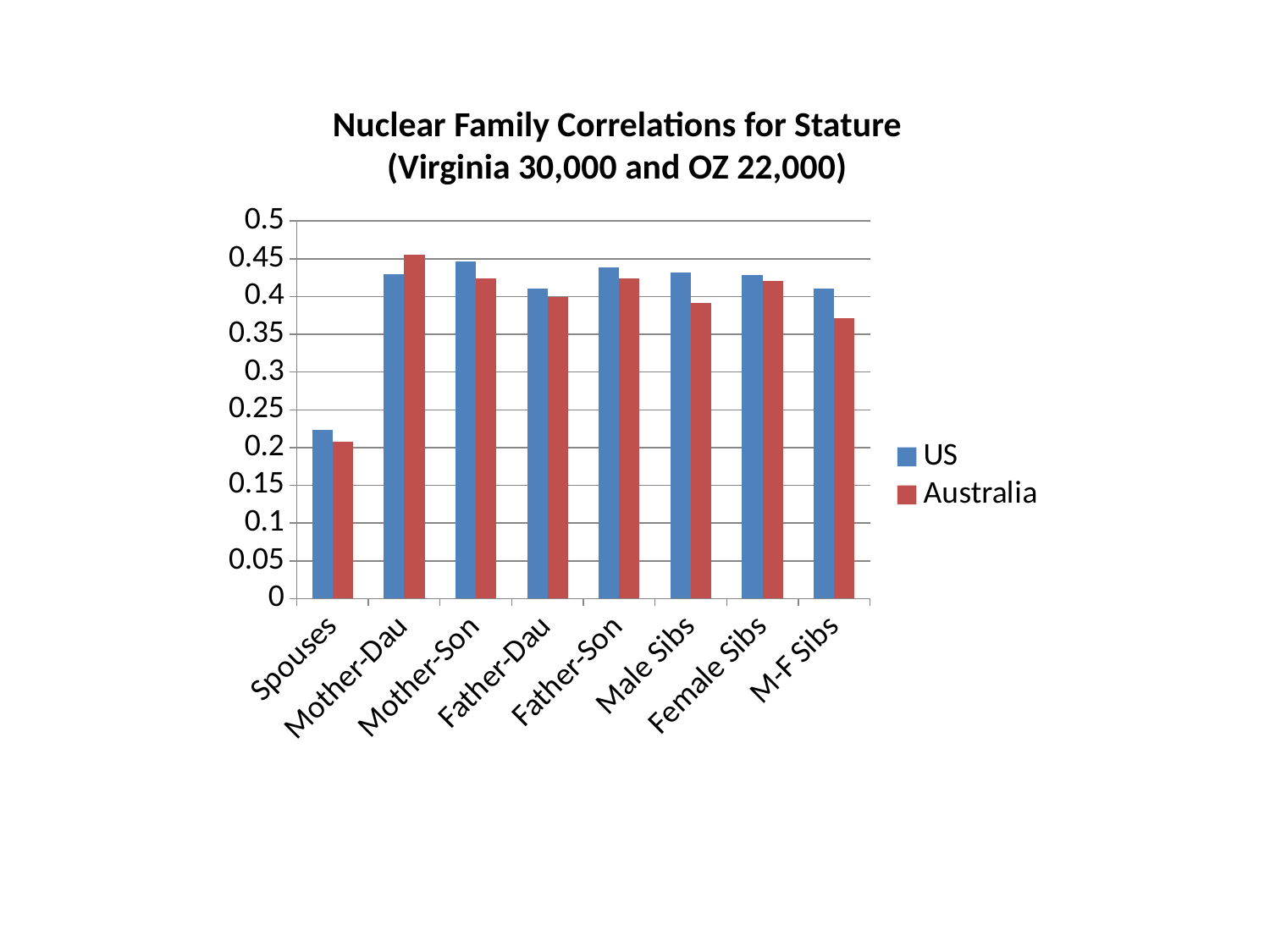
How many series does the legend list? 2 Is the Australia value for Father-Dau greater or less than 0.45? less For Male Sibs, which series has the larger value, US or Australia? US Which category has the highest Australia correlation? Mother-Dau What type of chart is shown on the slide? bar chart How many categories are shown on the x axis? 8 Which category has the lowest US correlation? Spouses What is the title of the chart? Nuclear Family Correlations for Stature (Virginia 30,000 and OZ 22,000) For Mother-Dau, which series has the larger value, US or Australia? Australia Is the US value for Spouses greater or less than 0.25? less Is the US value for Mother-Son greater or less than 0.4? greater